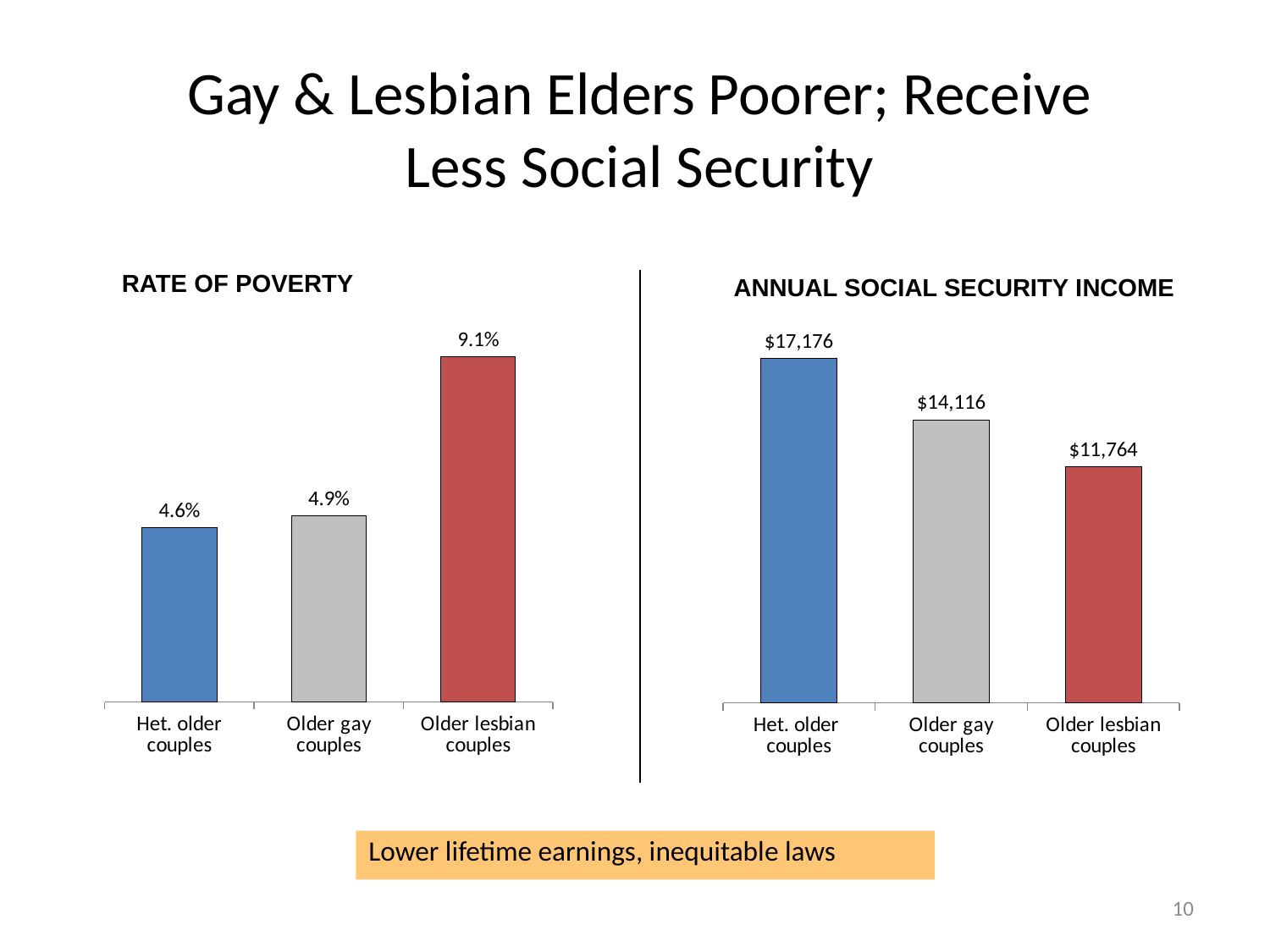
In the ANNUAL SOCIAL SECURITY INCOME chart, what is the value for Older gay couples? $14,116 In the ANNUAL SOCIAL SECURITY INCOME chart, which category has the lowest value? Older lesbian couples In the ANNUAL SOCIAL SECURITY INCOME chart, which is larger, Het. older couples or Older gay couples? Het. older couples In the RATE OF POVERTY chart, what is the difference between Older lesbian couples and Older gay couples? 4.2% In the RATE OF POVERTY chart, what is the value for Older lesbian couples? 9.1% In the RATE OF POVERTY chart, what is the value for Het. older couples? 4.6% In the ANNUAL SOCIAL SECURITY INCOME chart, what is the value for Older lesbian couples? $11,764 In the ANNUAL SOCIAL SECURITY INCOME chart, what is the difference between Het. older couples and Older lesbian couples? $5,412 In the RATE OF POVERTY chart, which category has the highest value? Older lesbian couples In the ANNUAL SOCIAL SECURITY INCOME chart, which category has the highest value? Het. older couples What kind of chart is the ANNUAL SOCIAL SECURITY INCOME chart? Bar chart How many categories are shown in the RATE OF POVERTY chart? 3